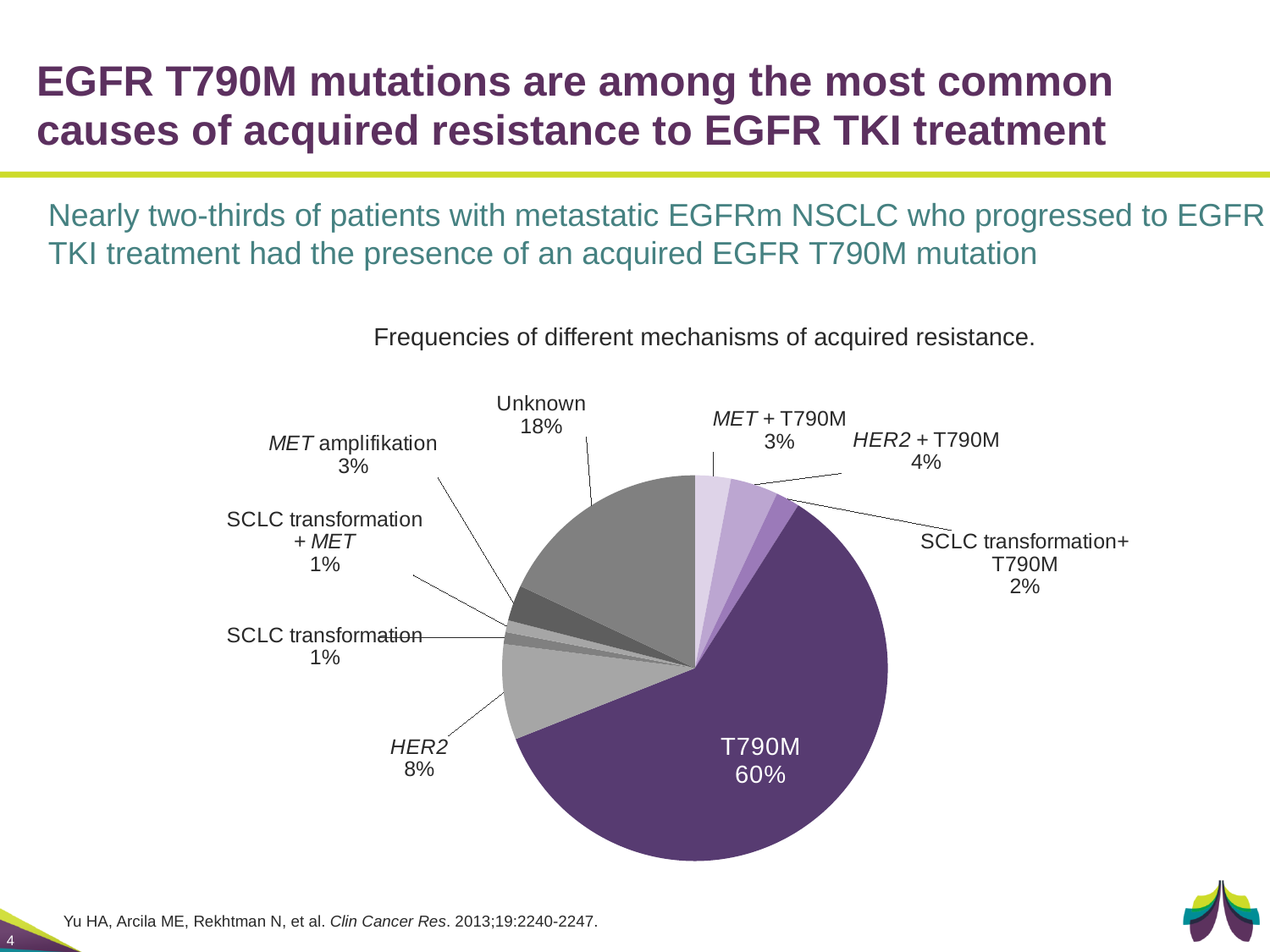
Which mechanism has the largest slice of the pie? T790M What percentage is shown for SCLC transformation+ T790M? 2% What percentage is shown for HER2 + T790M? 4% What percentage is shown for the Unknown slice? 18% What is the difference in percentage points between T790M and Unknown? 42 What is the title of the chart? Frequencies of different mechanisms of acquired resistance. How many slices does the pie chart have? 9 What is the combined percentage of SCLC transformation and SCLC transformation + MET? 2% What percentage is shown for HER2? 8% Which is larger, the HER2 slice or the MET amplification slice? HER2 What share of the pie does T790M account for? 60% What kind of chart is shown on the slide? Pie chart